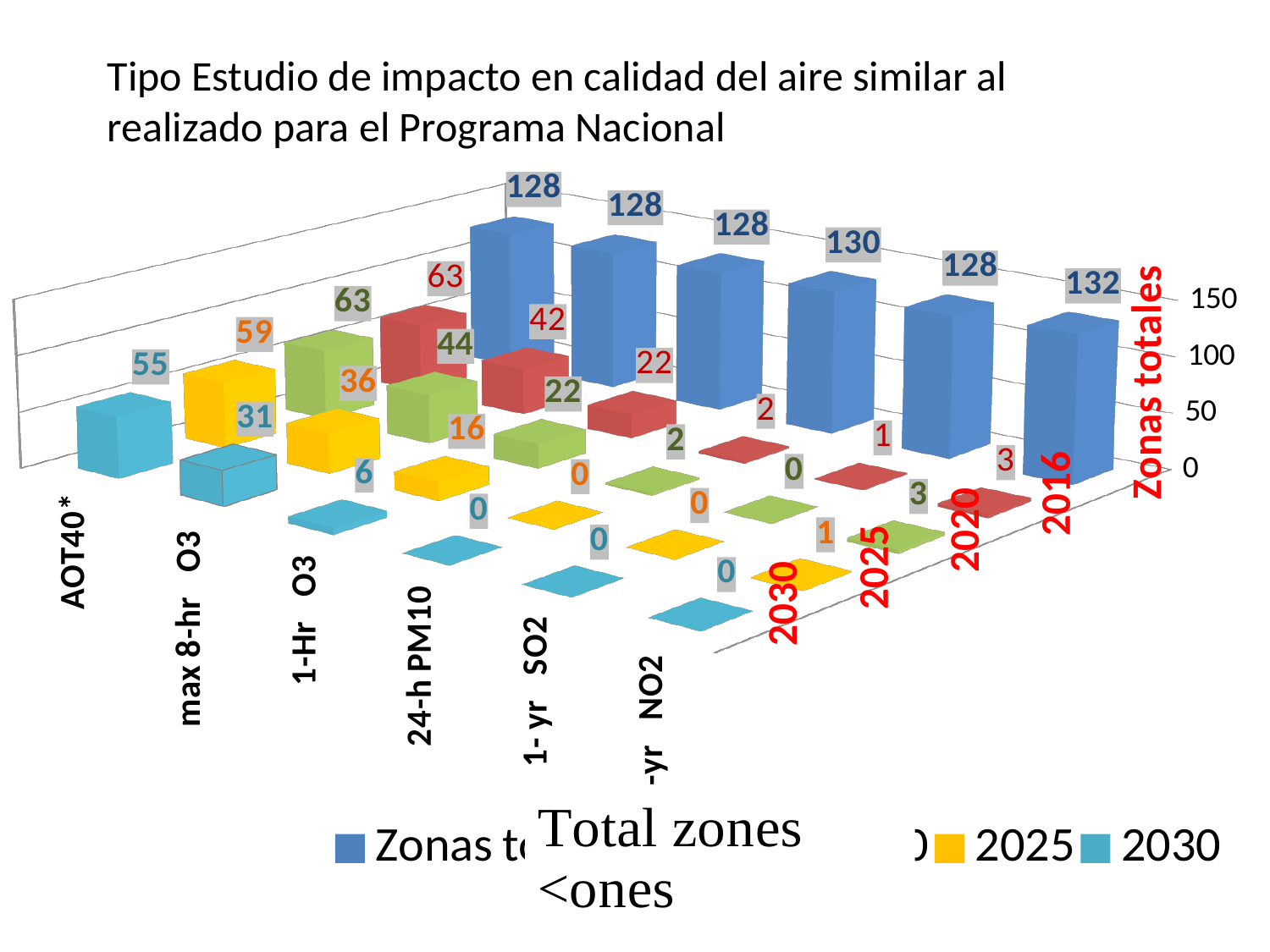
Which category has the highest Zonas totales value? 1-yr NO2 What is the difference between the 2016 and 2030 values for AOT40*? 8 What is the title of the vertical value axis? Zonas totales What is the Zonas totales value for 1-yr NO2? 132 For max 8-hr O3, which is larger: the 2020 value or the 2016 value? 2020 How many categories are shown along the category axis? 6 What kind of chart is shown on the slide? Bar chart What is the Zonas totales value for 24-h PM10? 130 What is the 2016 value for 1-Hr O3? 22 What is the 2025 value for max 8-hr O3? 36 For AOT40*, do the values rise or fall from 2016 to 2030? Fall What is the 2030 value for AOT40*? 55